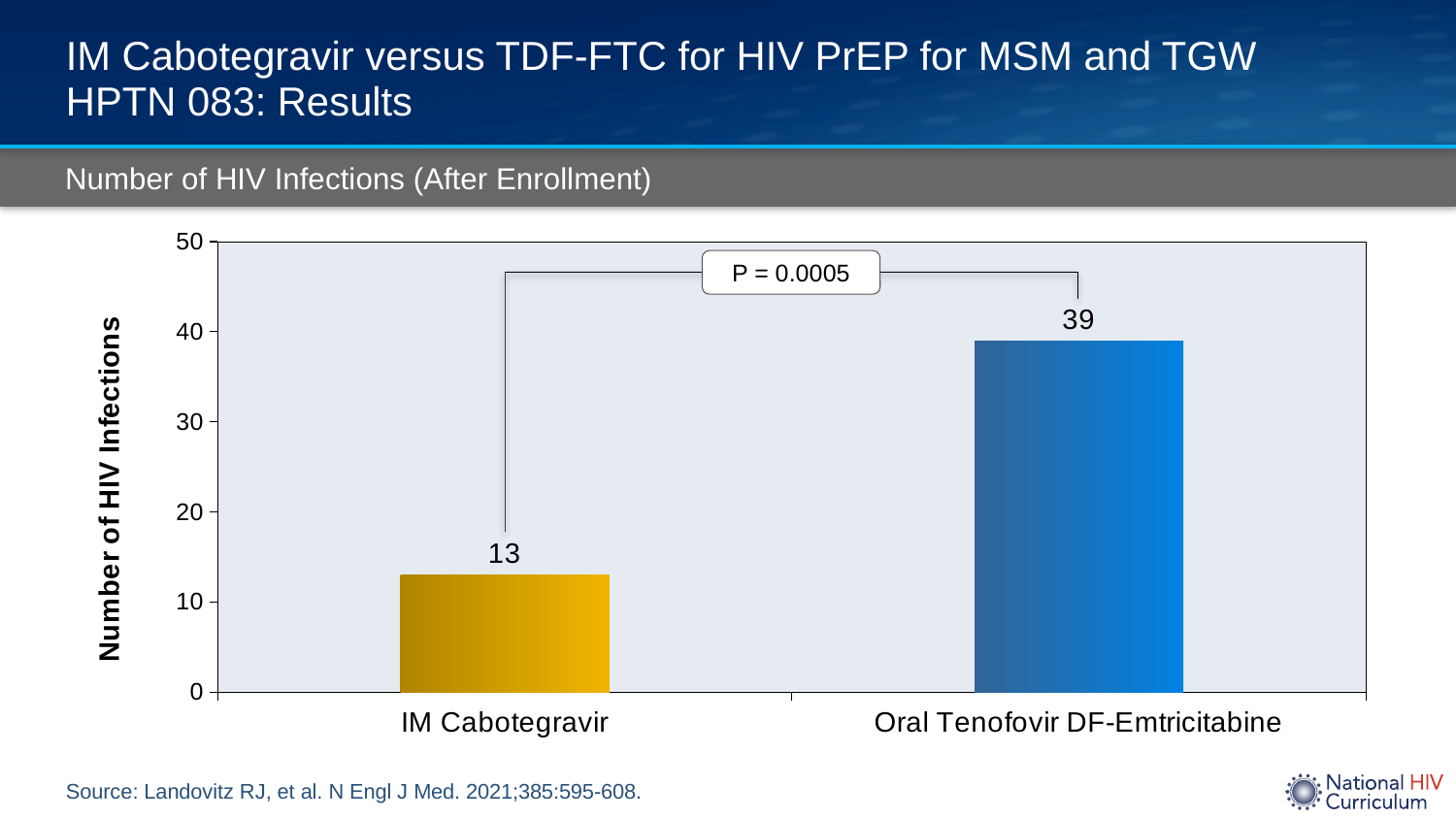
What is the difference in the number of HIV infections between Oral Tenofovir DF-Emtricitabine and IM Cabotegravir? 26 Which group had the lowest number of HIV infections? IM Cabotegravir What P value is shown on the chart? P = 0.0005 How many categories are shown on the x axis of the chart? 2 What is the label of the y axis of the chart? Number of HIV Infections Is the value for IM Cabotegravir greater or less than 20? less Which group had the highest number of HIV infections? Oral Tenofovir DF-Emtricitabine What kind of chart is shown on the slide? Bar chart Is the value for Oral Tenofovir DF-Emtricitabine greater or less than 30? greater Which had more HIV infections, IM Cabotegravir or Oral Tenofovir DF-Emtricitabine? Oral Tenofovir DF-Emtricitabine What is the number of HIV infections for IM Cabotegravir? 13 What is the number of HIV infections for Oral Tenofovir DF-Emtricitabine? 39